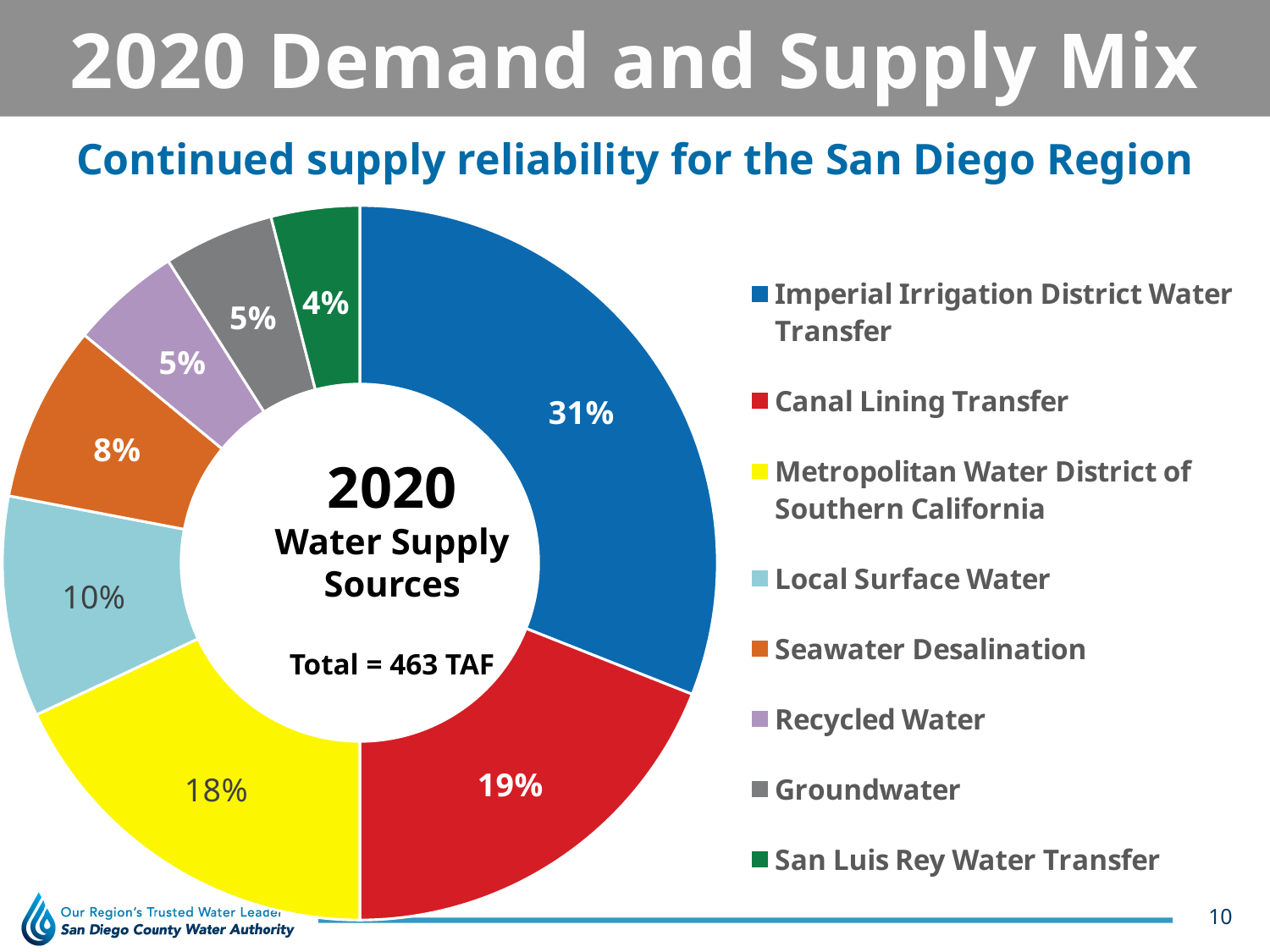
What percentage of the 2020 water supply comes from Seawater Desalination? 8% How many water supply sources are shown in the 2020 chart? 8 What percentage of the 2020 water supply is from Canal Lining Transfer? 19% Which water supply source has the smallest share in the 2020 chart? San Luis Rey Water Transfer Which has a larger share of the 2020 water supply, Local Surface Water or Seawater Desalination? Local Surface Water What total volume is shown in the center of the 2020 Water Supply Sources chart? 463 TAF What share of the 2020 water supply sources comes from the Imperial Irrigation District Water Transfer? 31% What is the difference in percentage points between the Imperial Irrigation District Water Transfer share and the Canal Lining Transfer share? 12 What kind of chart is used to show the 2020 water supply sources? Pie chart (donut) Which colour represents Recycled Water in the 2020 water supply chart? Purple What share does the Metropolitan Water District of Southern California contribute to the 2020 water supply? 18% Which water supply source has the largest share in the 2020 chart? Imperial Irrigation District Water Transfer